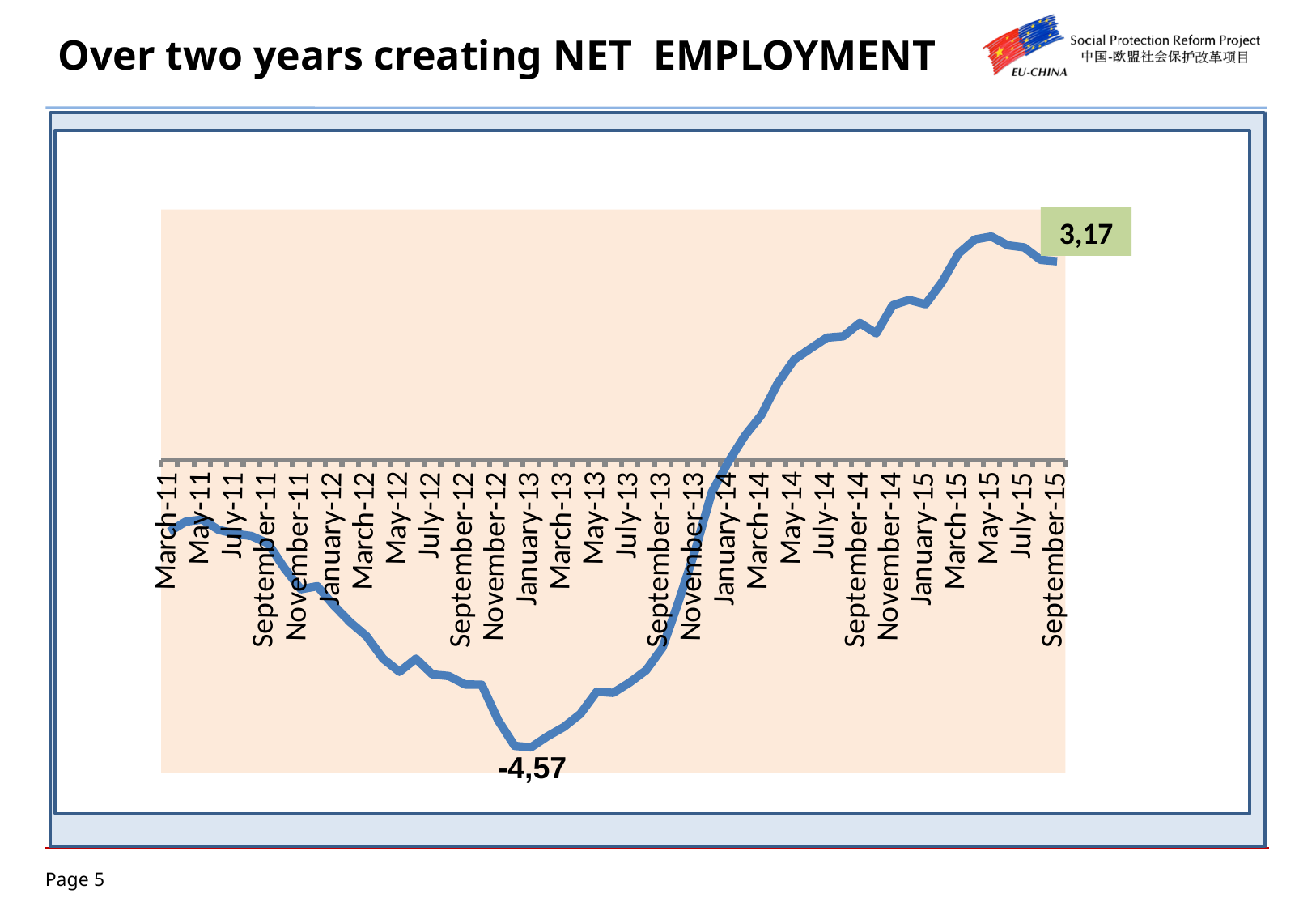
In which month does the line reach its lowest value? January-13 What is the difference between the September-15 value (3,17) and the January-13 value (-4,57)? 7,74 Does the line rise or fall between March-11 and January-13? fall What is the first month label on the x axis? March-11 Is the value for July-12 greater or less than 0? less Does the line rise or fall between January-13 and May-15? rise What is the value labelled at the lowest point of the line, in January-13? -4,57 What kind of chart is shown on the slide? line chart Which is larger, the value for September-15 or the value for January-13? September-15 Is the value for March-14 greater or less than 0? greater How many month labels are shown on the x axis? 28 What is the value labelled at the end of the line, in September-15? 3,17